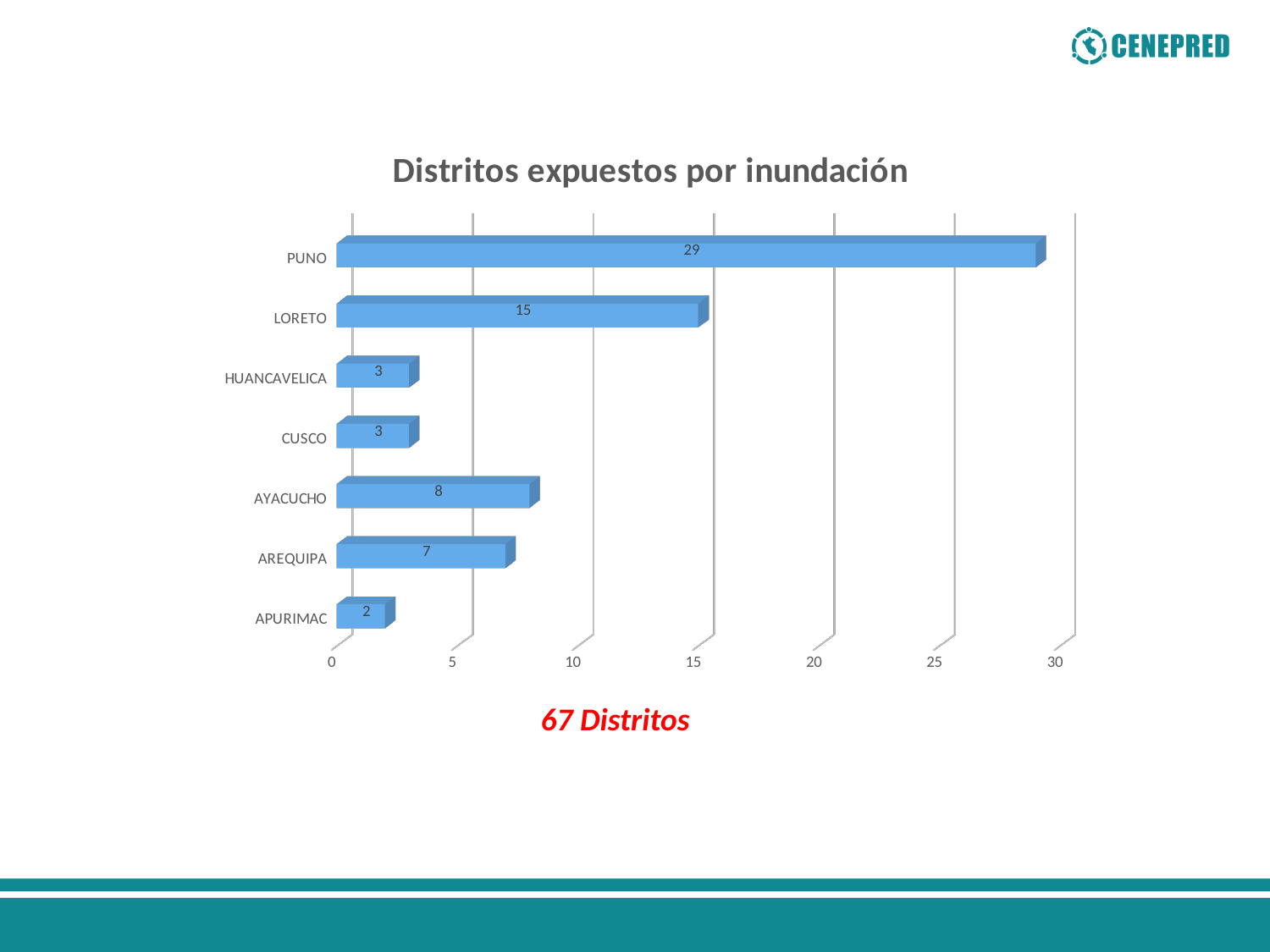
What is the value for LORETO? 15 What is the value for APURIMAC? 2 Which category has the lowest value? APURIMAC What is the value for AYACUCHO? 8 What is the title of the chart? Distritos expuestos por inundación Which category has the highest value? PUNO Which is larger, the value for AYACUCHO or the value for AREQUIPA? AYACUCHO What kind of chart is shown on the slide? bar chart What is the value for PUNO? 29 How many categories are shown in the chart? 7 What is the difference between the values for PUNO and LORETO? 14 Is the value for LORETO greater or less than 10? greater